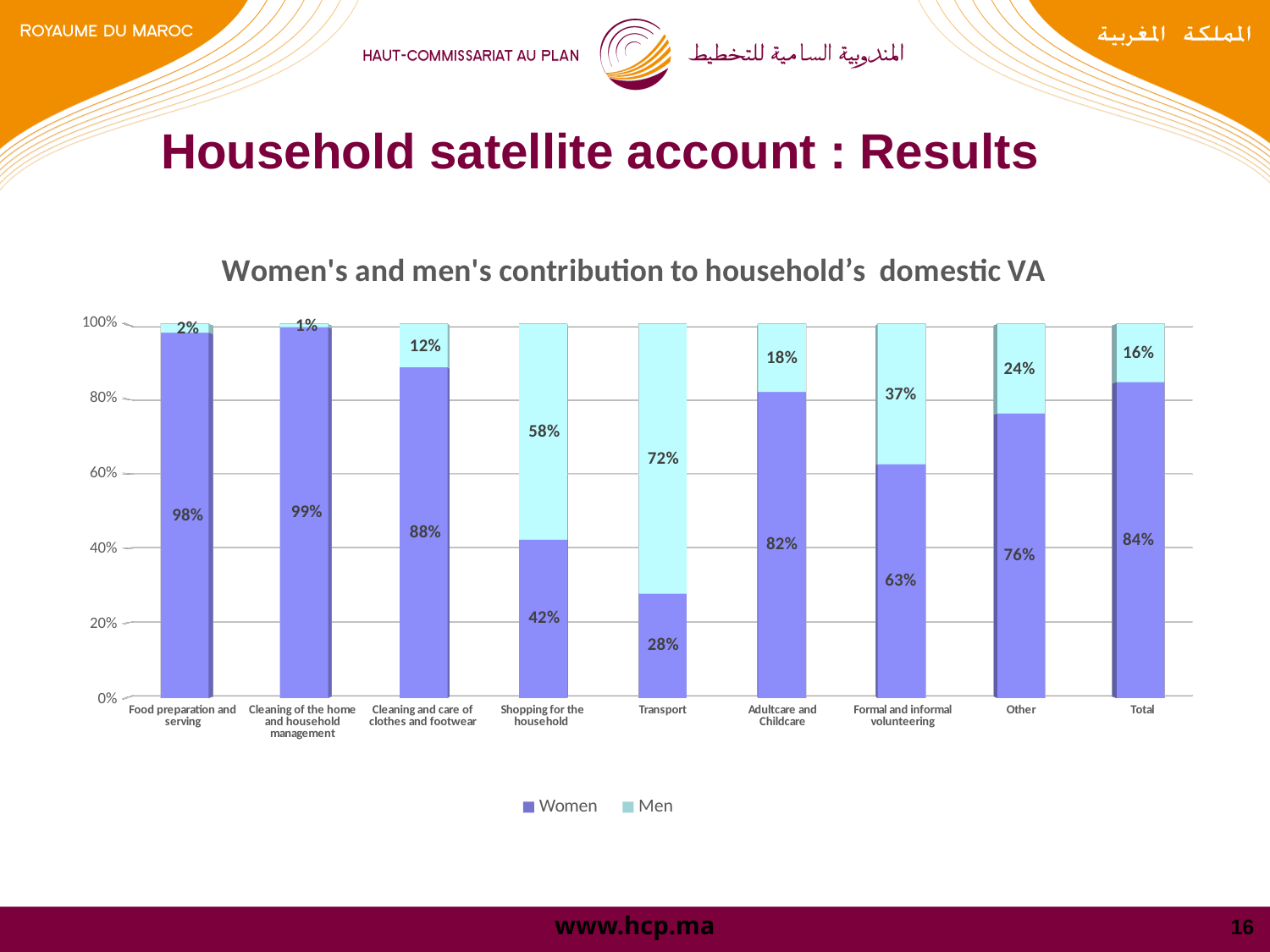
What is the difference between the Women value for Adultcare and Childcare and the Women value for Other? 6% What kind of chart is shown? Stacked bar chart What is the title of the chart? Women's and men's contribution to household's domestic VA Which category has the highest Women value? Cleaning of the home and household management Which category has the lowest Women value? Transport Which category has the highest Men value? Transport What is the Men value for Formal and informal volunteering? 37% What is the Women value for Transport? 28% Which is larger: the Men value for Shopping for the household or the Men value for Formal and informal volunteering? Shopping for the household How many series does the legend list? 2 What is the Women value for Total? 84% How many categories are shown on the x axis? 9